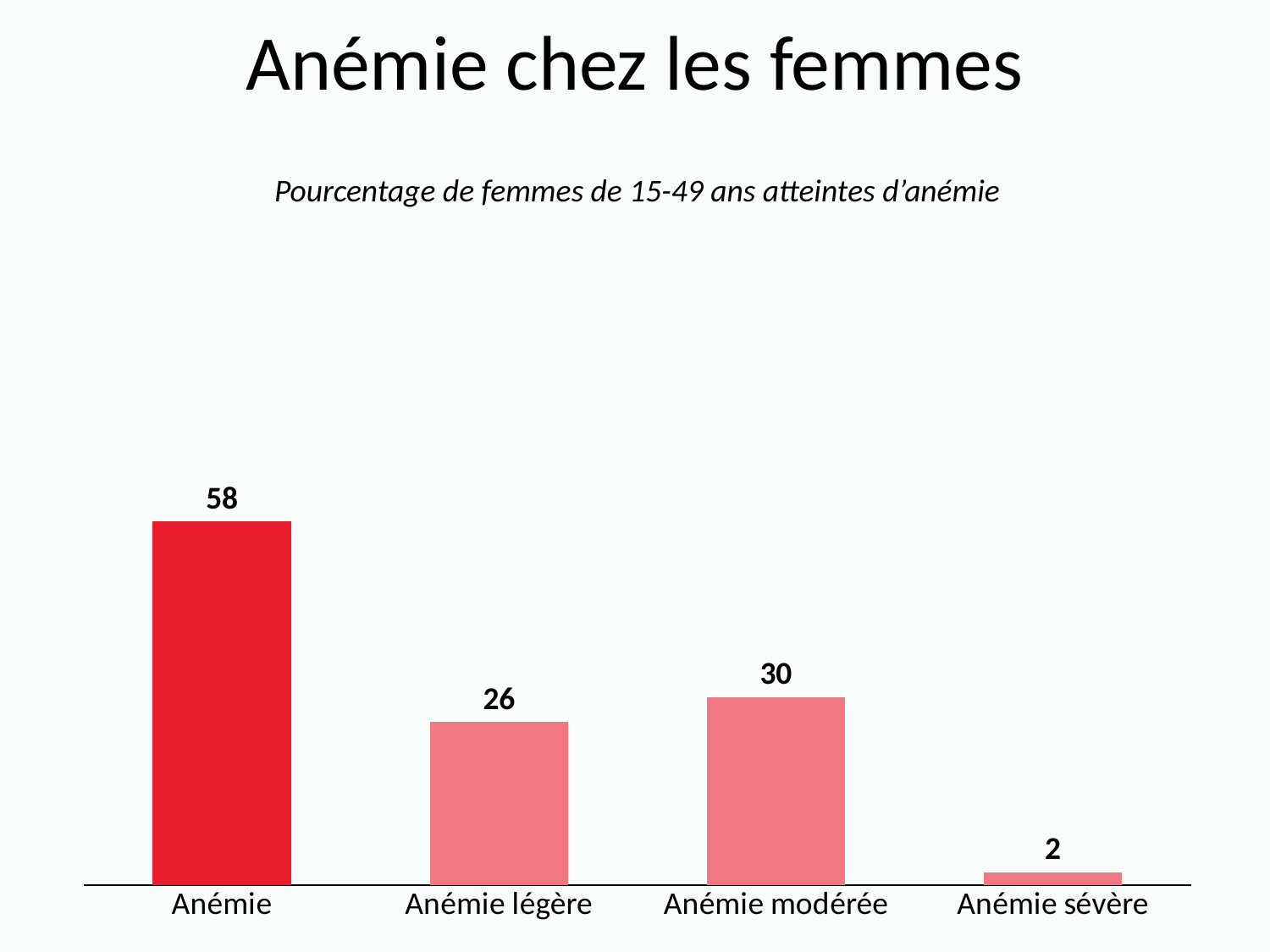
What is the difference between the values for Anémie modérée and Anémie légère? 4 Which is larger, the value for Anémie légère or Anémie modérée? Anémie modérée What is the value for Anémie modérée? 30 What is the value for Anémie sévère? 2 What is the value for Anémie? 58 Which category has the highest value? Anémie What kind of chart is shown on the slide? Bar chart What is the title of the slide? Anémie chez les femmes How many categories are shown in the chart? 4 What is the value for Anémie légère? 26 What is the difference between the values for Anémie and Anémie modérée? 28 Which category has the lowest value? Anémie sévère